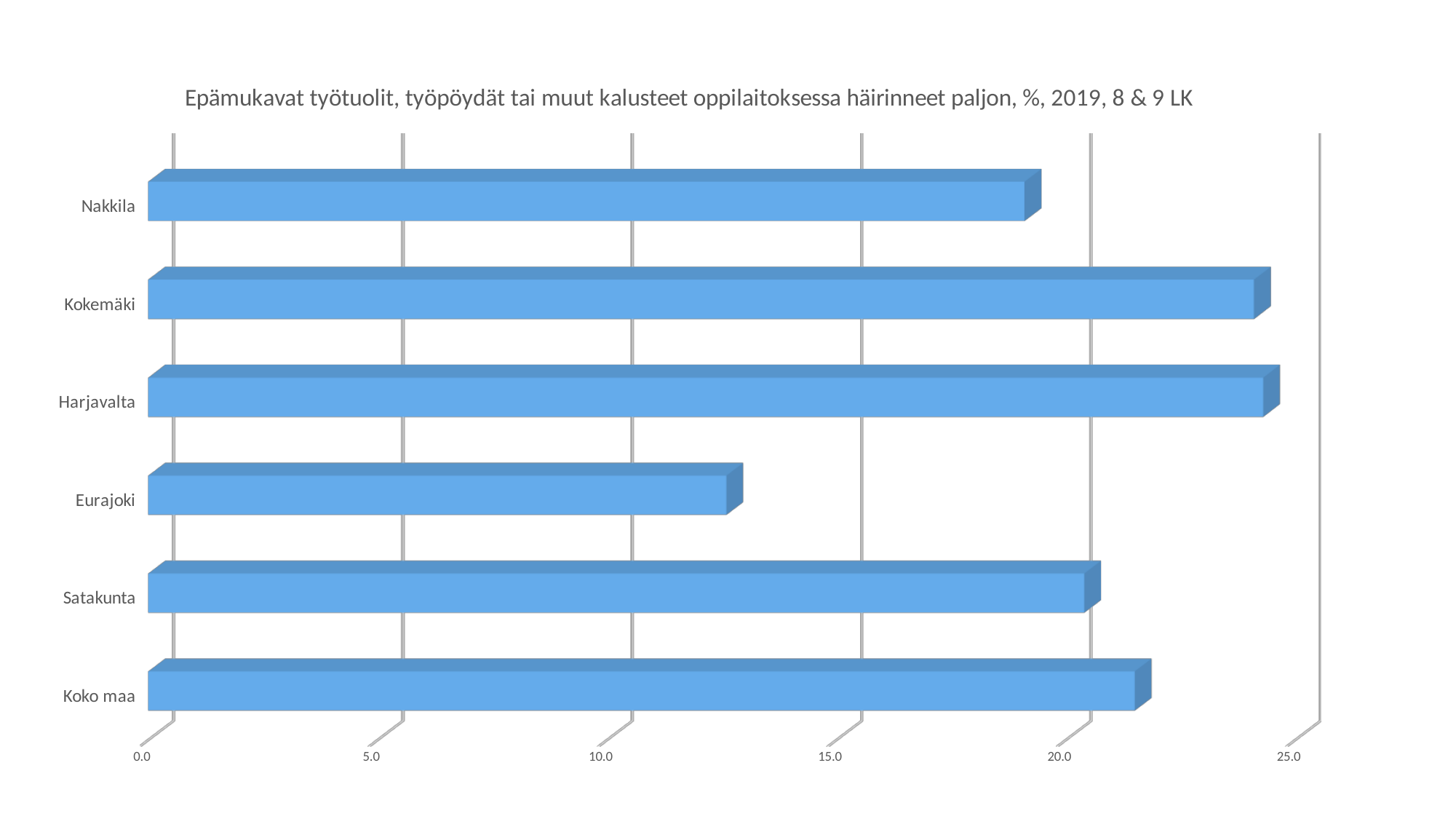
Which has the larger value, Nakkila or Eurajoki? Nakkila What is the title of the chart? Epämukavat työtuolit, työpöydät tai muut kalusteet oppilaitoksessa häirinneet paljon, %, 2019, 8 & 9 LK What kind of chart is shown on the slide? bar chart Is the value for Eurajoki greater or less than 10.0? greater Is the value for Nakkila greater or less than 20.0? less Is the value for Kokemäki greater or less than 20.0? greater How many categories are plotted in the chart? 6 Which has the larger value, Kokemäki or Nakkila? Kokemäki Which category has the lowest value in the chart? Eurajoki Which has the larger value, Koko maa or Satakunta? Koko maa